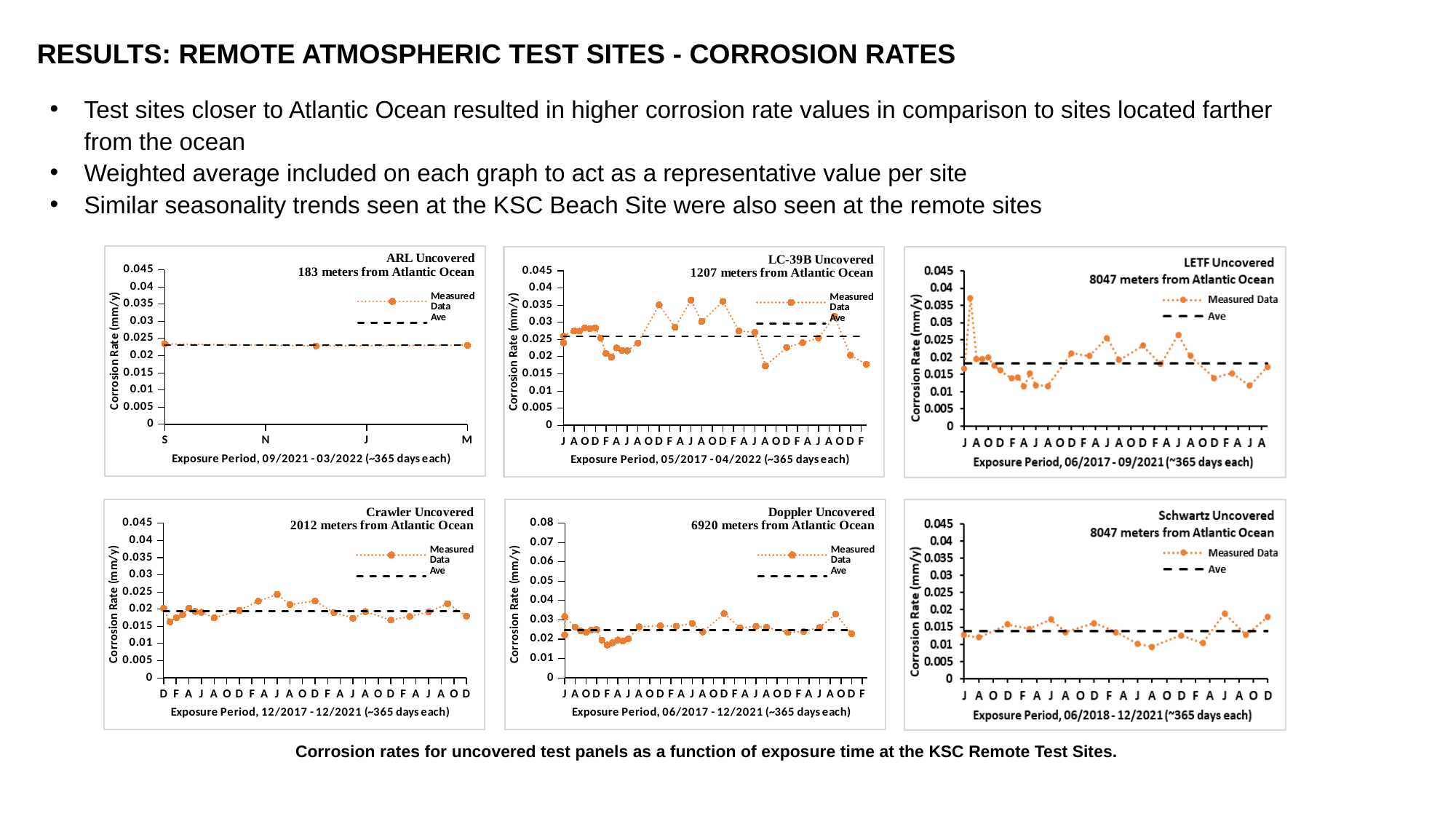
On the ARL Uncovered chart, is the Ave line greater or less than 0.02? greater On the Doppler Uncovered chart, is the highest measured data value greater or less than 0.04? less Which chart has a higher Ave line, ARL Uncovered or Schwartz Uncovered? ARL Uncovered What kind of chart is the ARL Uncovered chart? line chart On the LC-39B Uncovered chart, is the Ave line greater or less than 0.02? greater How many charts are shown on the slide? 6 According to the LC-39B Uncovered chart title, how far is the site from the Atlantic Ocean? 1207 meters How many series does the legend of the LC-39B Uncovered chart list? 2